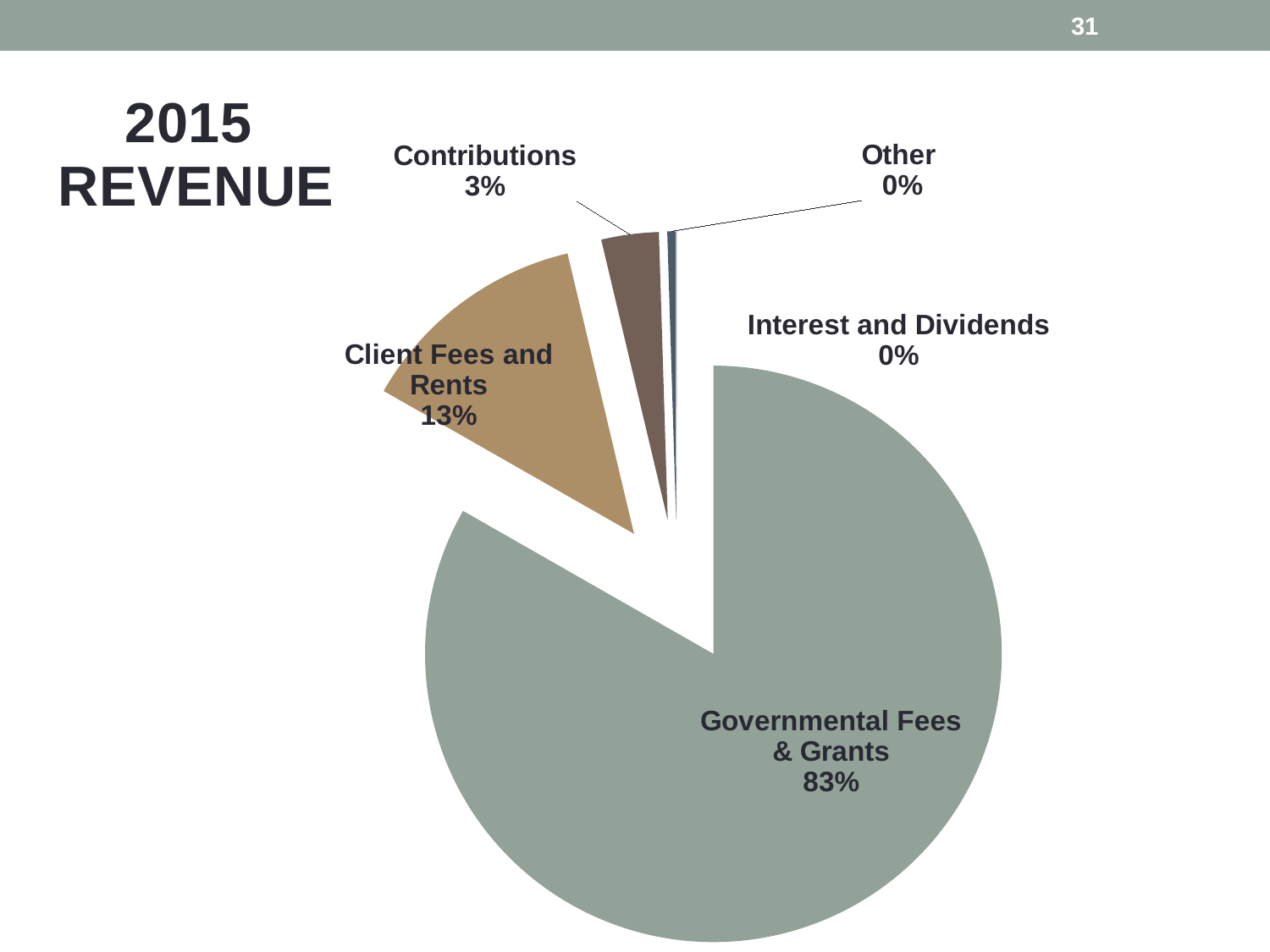
What is the title of the chart on the slide? 2015 REVENUE Which revenue category has the largest share? Governmental Fees & Grants What kind of chart is shown on the slide? pie chart What percentage is shown for Interest and Dividends? 0% What share of 2015 revenue comes from Governmental Fees & Grants? 83% What share of 2015 revenue comes from Contributions? 3% Which is larger, Client Fees and Rents or Contributions? Client Fees and Rents What is the difference in percentage points between Governmental Fees & Grants and Client Fees and Rents? 70 What is the combined share of Client Fees and Rents and Contributions? 16% How many categories are labelled on the pie chart? 5 What share of 2015 revenue comes from Client Fees and Rents? 13% What percentage is shown for Other? 0%